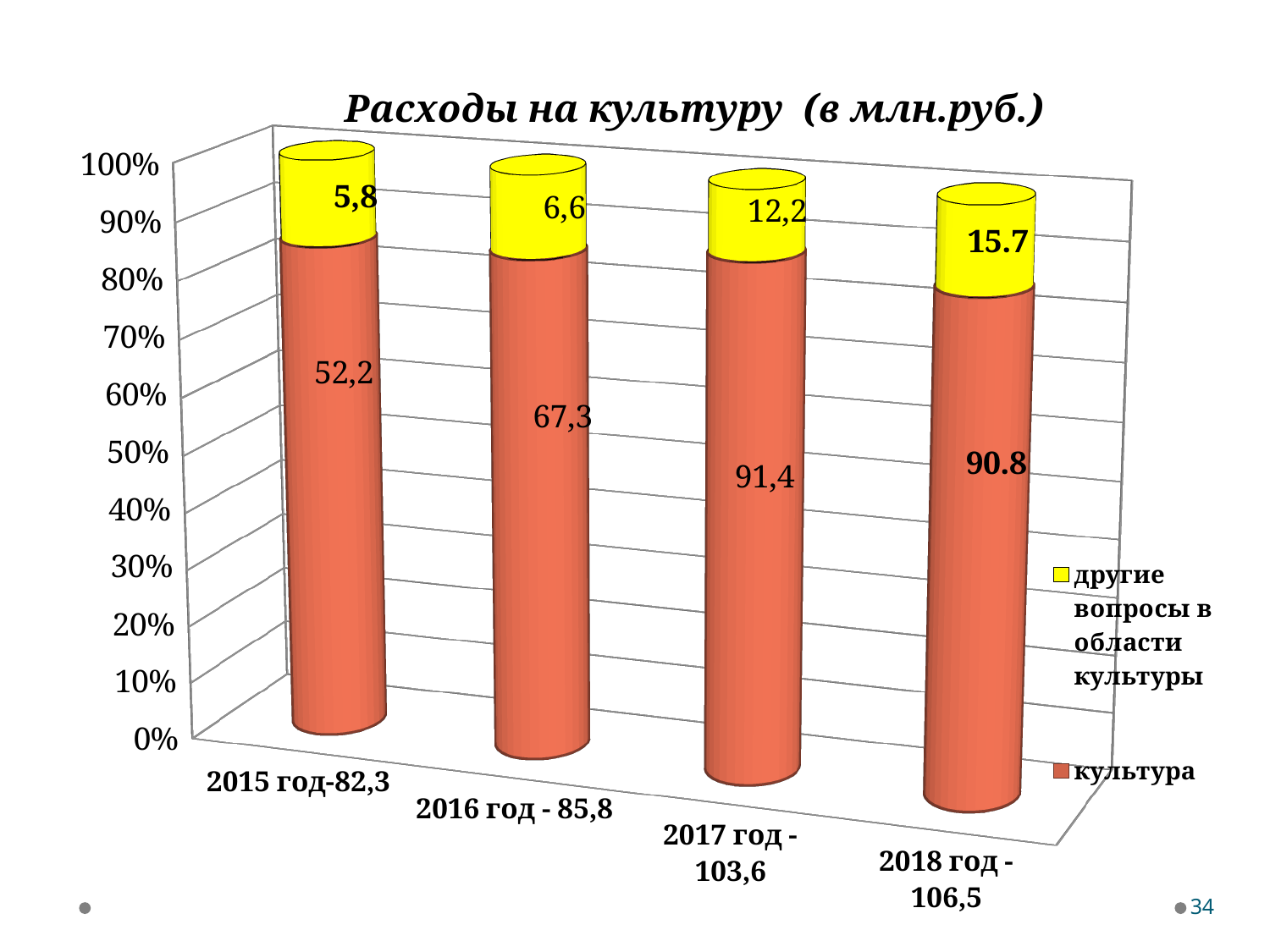
Which year has the highest value for другие вопросы в области культуры? 2018 год - 106,5 What is the value for культура in 2015 год-82,3? 52,2 What is the value for другие вопросы в области культуры in 2017 год - 103,6? 12,2 Do the values for другие вопросы в области культуры rise or fall from 2015 to 2018? rise What kind of chart is shown on the slide? stacked bar chart Which is larger: the другие вопросы в области культуры value for 2016 год - 85,8 or for 2015 год-82,3? 2016 год - 85,8 Which year has the lowest value for культура? 2015 год-82,3 How many series does the legend list? 2 What is the value for культура in 2018 год - 106,5? 90.8 What is the difference between the культура values for 2017 год - 103,6 and 2016 год - 85,8? 24,1 Is the share of the bar taken by культура in 2015 год-82,3 greater or less than 80%? greater How many years are shown on the x axis? 4